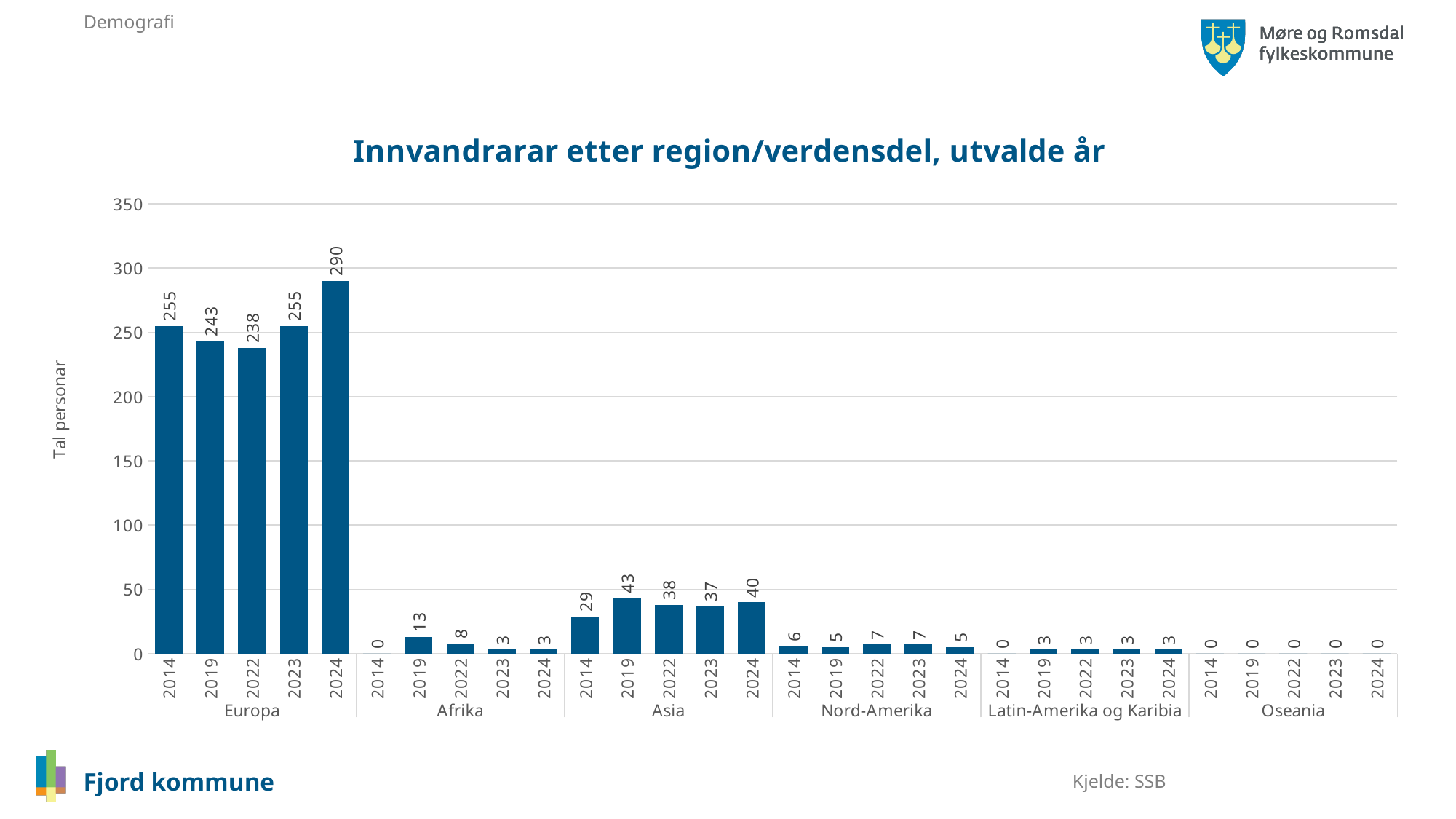
What is the value for Afrika in 2022? 8 What is the value for Europa in 2024? 290 Which year has the lowest value for Europa? 2022 What is the value for Asia in 2019? 43 How many regions are shown on the x axis? 6 What is the difference between the Europa values for 2024 and 2014? 35 What kind of chart is this? bar chart Which is larger: the value for Asia in 2022 or the value for Asia in 2023? Asia in 2022 Is the value for Europa in 2019 greater or less than 250? less What is the title of the chart? Innvandrarar etter region/verdensdel, utvalde år What is the value for Oseania in 2024? 0 Which year has the highest value for Europa? 2024